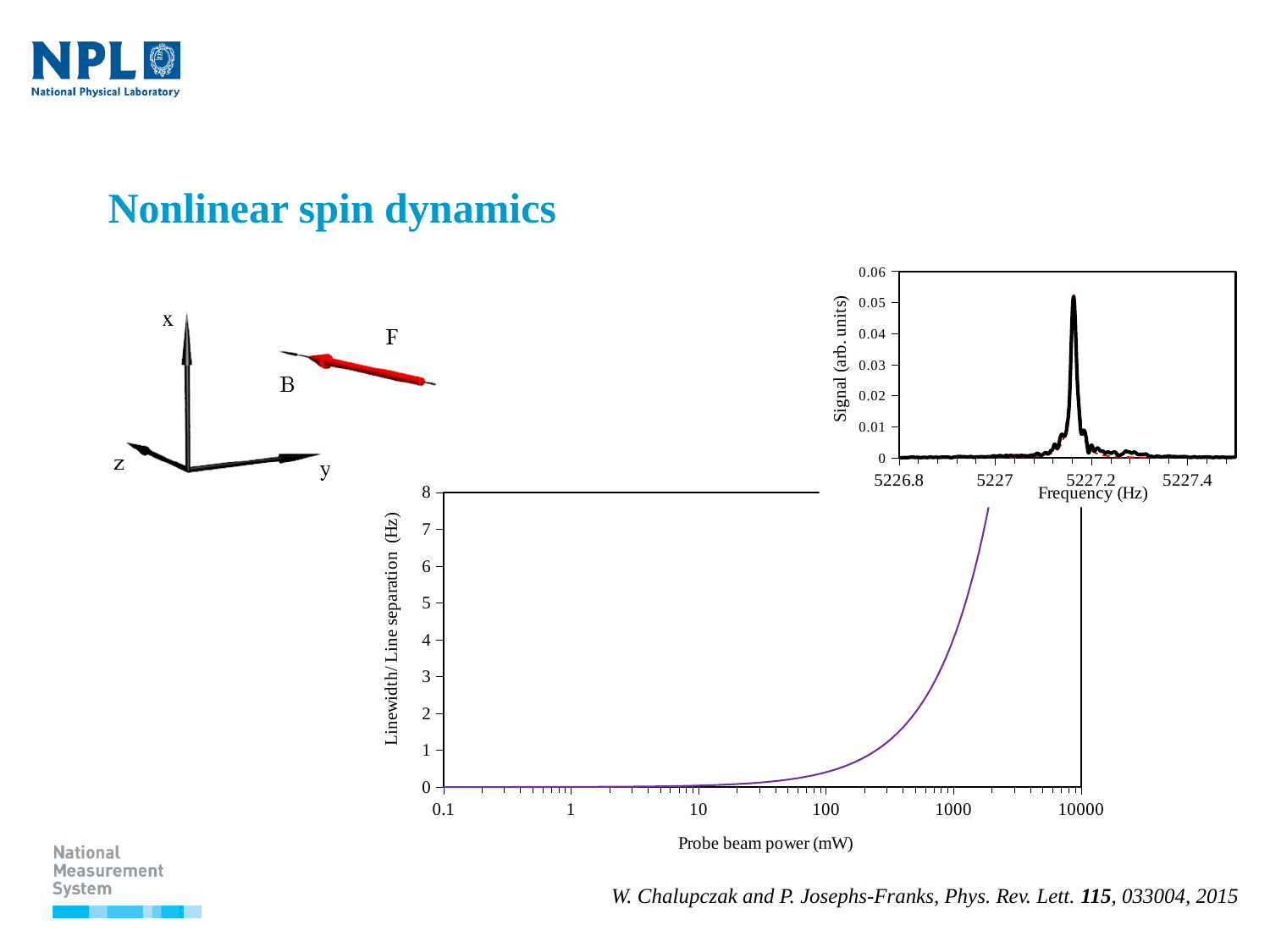
In the bottom chart, is the Linewidth/Line separation at a probe beam power of 10 mW greater or less than 1? less In the top-right chart, is the signal at a frequency of 5226.8 Hz greater or less than 0.01? less In the top-right chart, which is larger: the signal at 5227.4 Hz or the peak signal near 5227.15 Hz? the peak near 5227.15 Hz In the bottom chart, is the Linewidth/Line separation at a probe beam power of 100 mW greater or less than 1? less What is the y axis label of the bottom chart? Linewidth/ Line separation (Hz) In the bottom chart, which is larger: the Linewidth/Line separation at 100 mW or at 1000 mW? 1000 mW What kind of chart is the bottom chart with x axis 'Probe beam power (mW)'? line chart What kind of chart is the top-right chart with y axis 'Signal (arb. units)'? line chart In the bottom chart (Probe beam power), does the Linewidth/Line separation rise or fall as probe beam power increases? rise What is the x axis label of the top-right chart? Frequency (Hz)